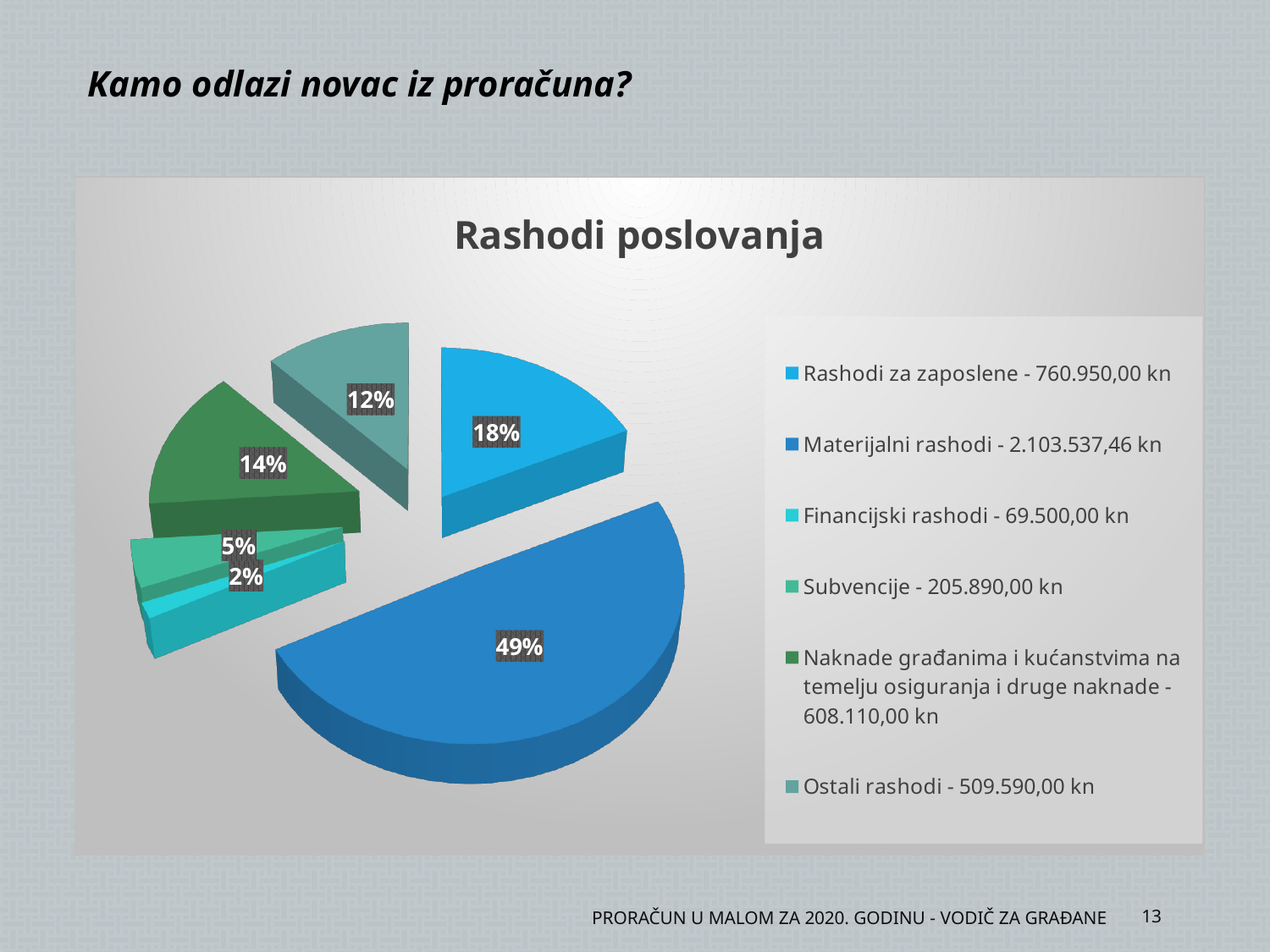
What share of the pie does Subvencije represent? 5% What is the difference in percentage points between the Materijalni rashodi slice and the Rashodi za zaposlene slice? 31 percentage points Which category has the largest slice of the pie? Materijalni rashodi What share of the pie does Materijalni rashodi represent? 49% What share of the pie does Rashodi za zaposlene represent? 18% What is the title of the chart? Rashodi poslovanja What kind of chart is shown on the slide? pie chart Which category has the smallest slice of the pie? Financijski rashodi Which is larger, the share for Rashodi za zaposlene or the share for Ostali rashodi? Rashodi za zaposlene How many slices does the pie chart have? 6 What amount in kn is listed in the legend for Naknade građanima i kućanstvima na temelju osiguranja i druge naknade? 608.110,00 kn